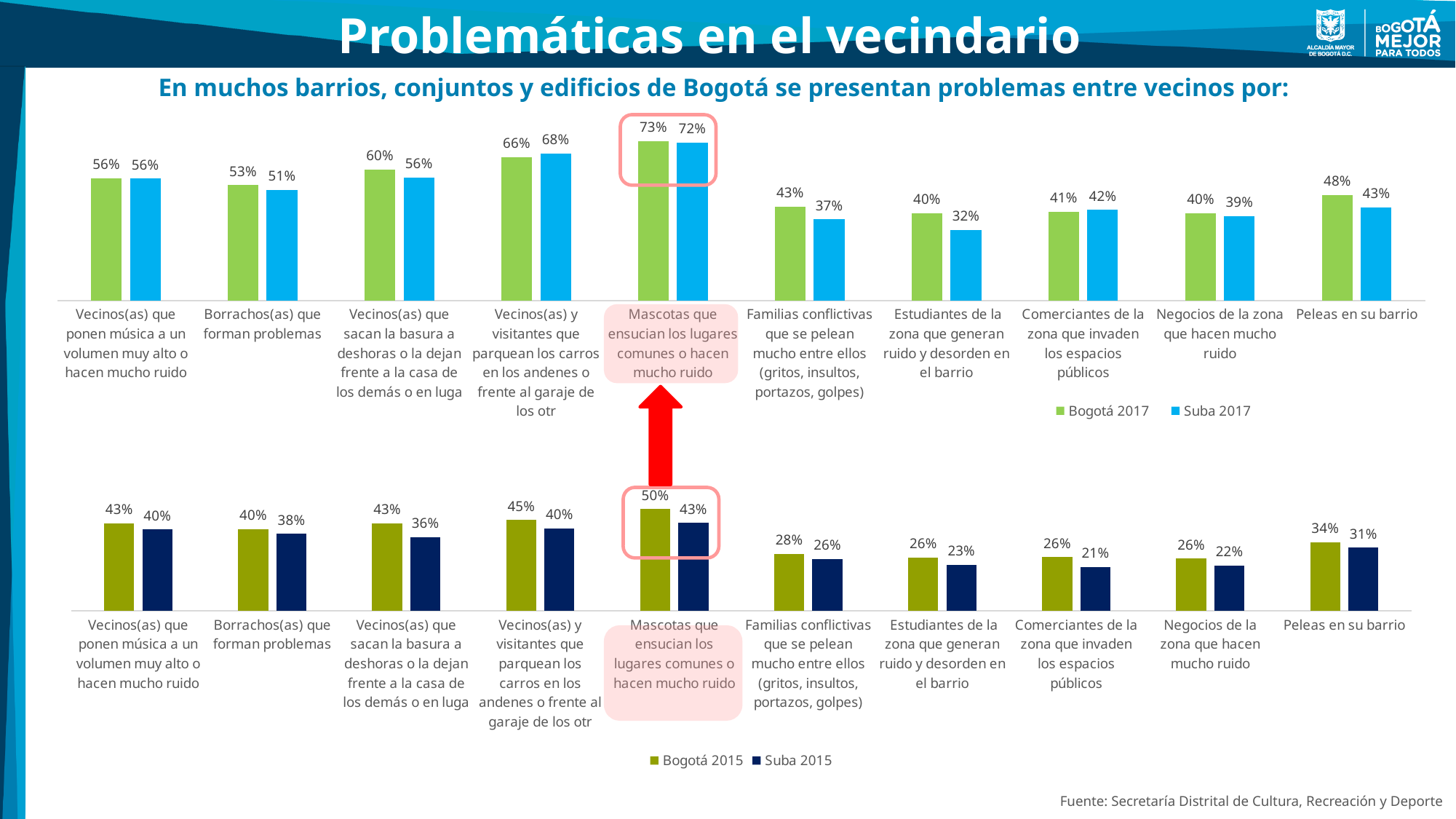
In the top chart (2017), what is the difference between Bogotá 2017 and Suba 2017 for "Estudiantes de la zona que generan ruido y desorden en el barrio"? 8% In the top chart (2017), which category has the lowest value for Suba 2017? Estudiantes de la zona que generan ruido y desorden en el barrio In the top chart (2017), what is the value for Suba 2017 for "Estudiantes de la zona que generan ruido y desorden en el barrio"? 32% How many series does the legend of the top chart (2017) list? 2 Which series does the legend of the bottom chart (2015) show in dark blue? Suba 2015 What type of chart is the bottom chart (2015)? Bar chart In the bottom chart (2015), which category has the highest value for Suba 2015? Mascotas que ensucian los lugares comunes o hacen mucho ruido In the top chart (2017), what is the value for Bogotá 2017 for "Mascotas que ensucian los lugares comunes o hacen mucho ruido"? 73% In the bottom chart (2015), what is the value for Bogotá 2015 for "Peleas en su barrio"? 34% In the top chart (2017), which is larger for "Vecinos(as) y visitantes que parquean los carros en los andenes o frente al garaje de los otr": Bogotá 2017 or Suba 2017? Suba 2017 In the bottom chart (2015), what is the difference between Bogotá 2015 and Suba 2015 for "Vecinos(as) que sacan la basura a deshoras o la dejan frente a la casa de los demás o en luga"? 7% How many categories are shown in the bottom chart (2015)? 10